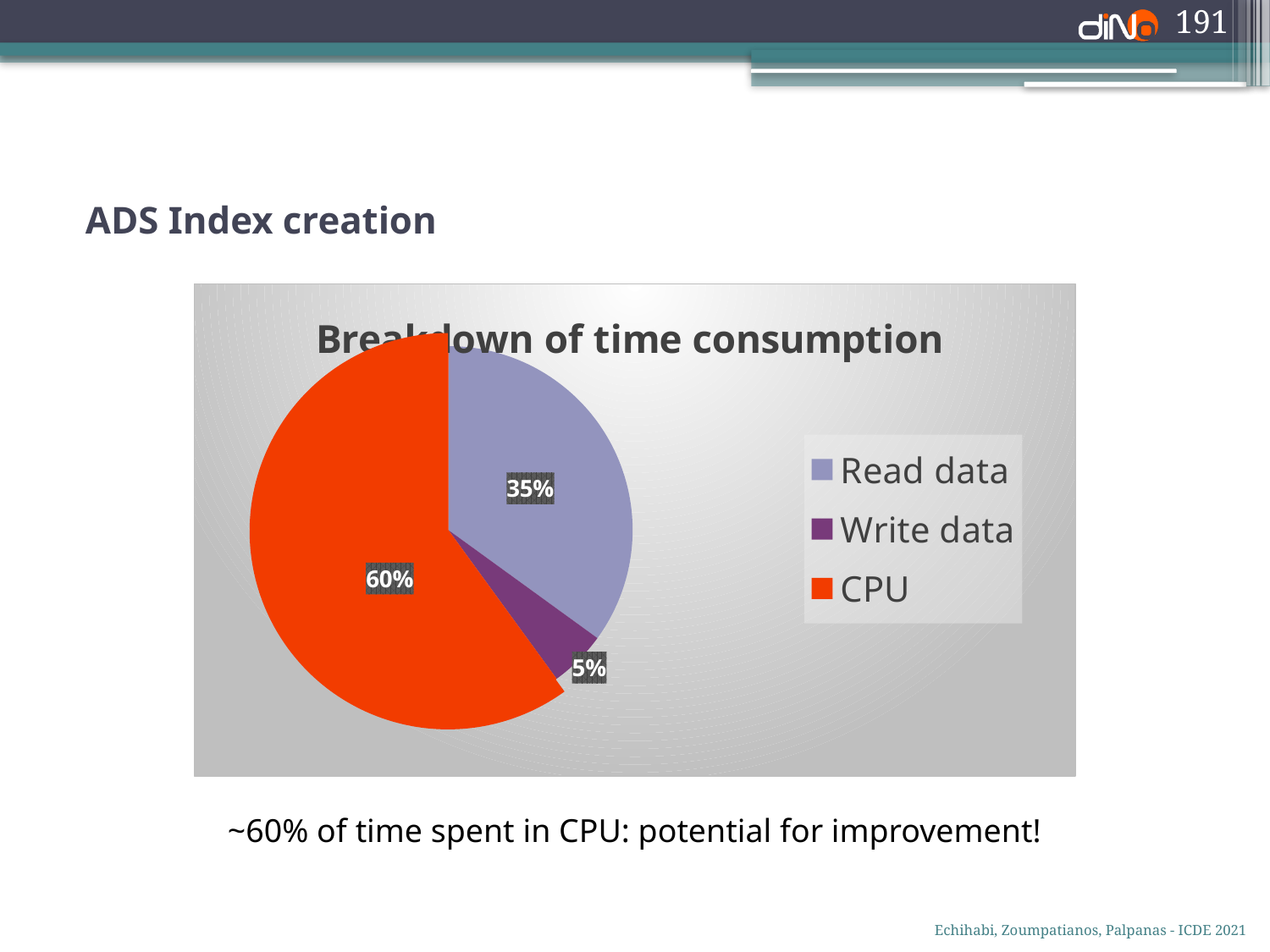
What share of time consumption does Read data account for? 35% What kind of chart is shown on the slide? Pie chart Which is larger, the share for Read data or the share for Write data? Read data What share of time consumption does CPU account for? 60% Which category has the smallest share of time consumption? Write data What is the difference between the CPU share and the Read data share? 25% Which category has the largest share of time consumption? CPU What is the title of the chart? Breakdown of time consumption What share of time consumption does Write data account for? 5% How many categories does the pie chart show? 3 What is the difference between the Read data share and the Write data share? 30% Which category is shown in orange-red in the pie chart? CPU